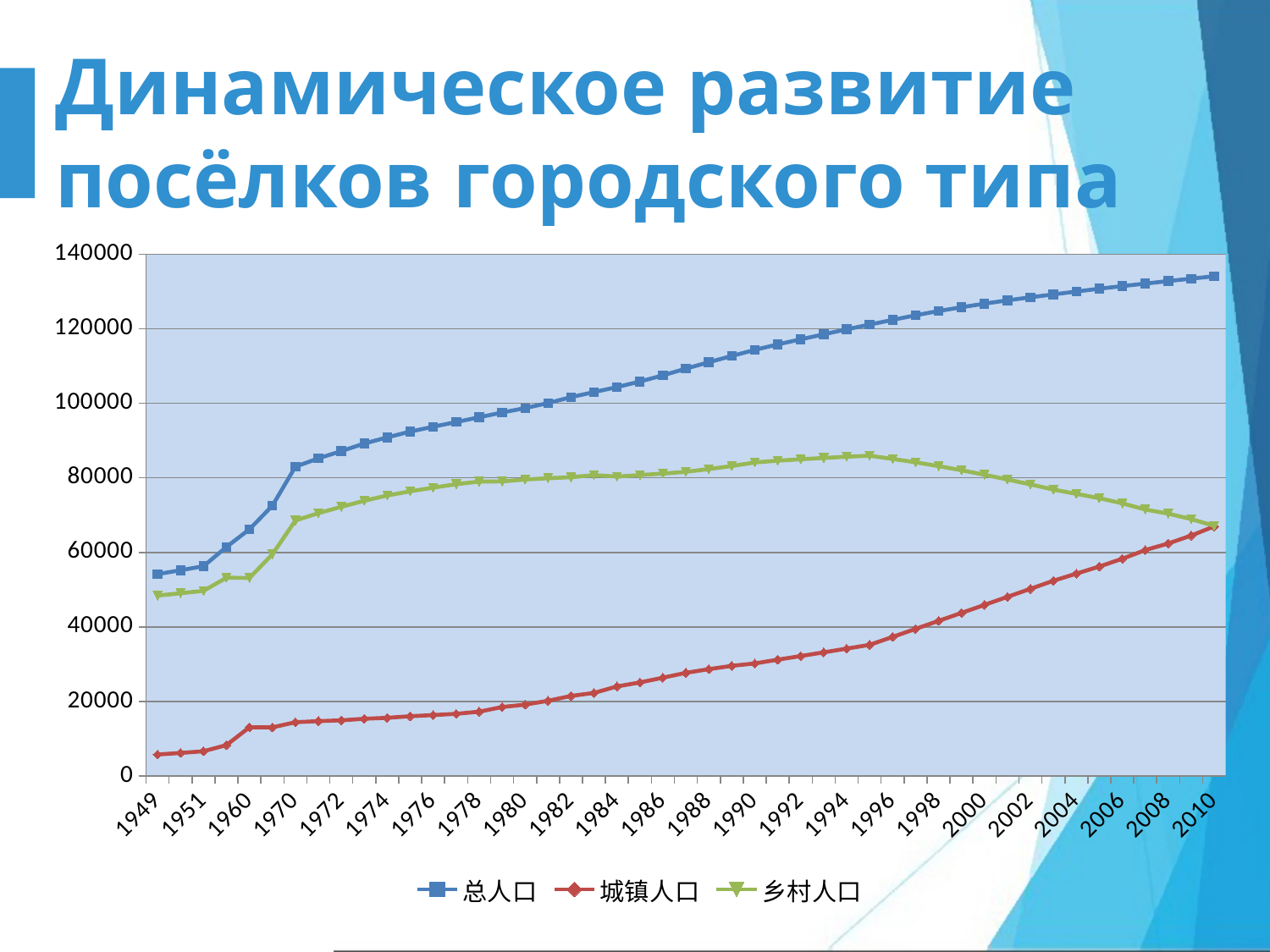
What kind of chart is shown on the slide? line chart How many series does the legend list? 3 Which series has the highest value in 2000? 总人口 Is the value of 城镇人口 in 1949 greater or less than 20000? less Is the value of 城镇人口 in 2010 greater or less than 60000? greater Is the value of 总人口 in 1949 greater or less than 60000? less In 1980, which series has the larger value: 乡村人口 or 城镇人口? 乡村人口 Does the 城镇人口 series rise or fall from 1949 to 2010? rise What are the three series named in the legend? 总人口, 城镇人口, 乡村人口 What is the title of the slide above the chart? Динамическое развитие посёлков городского типа